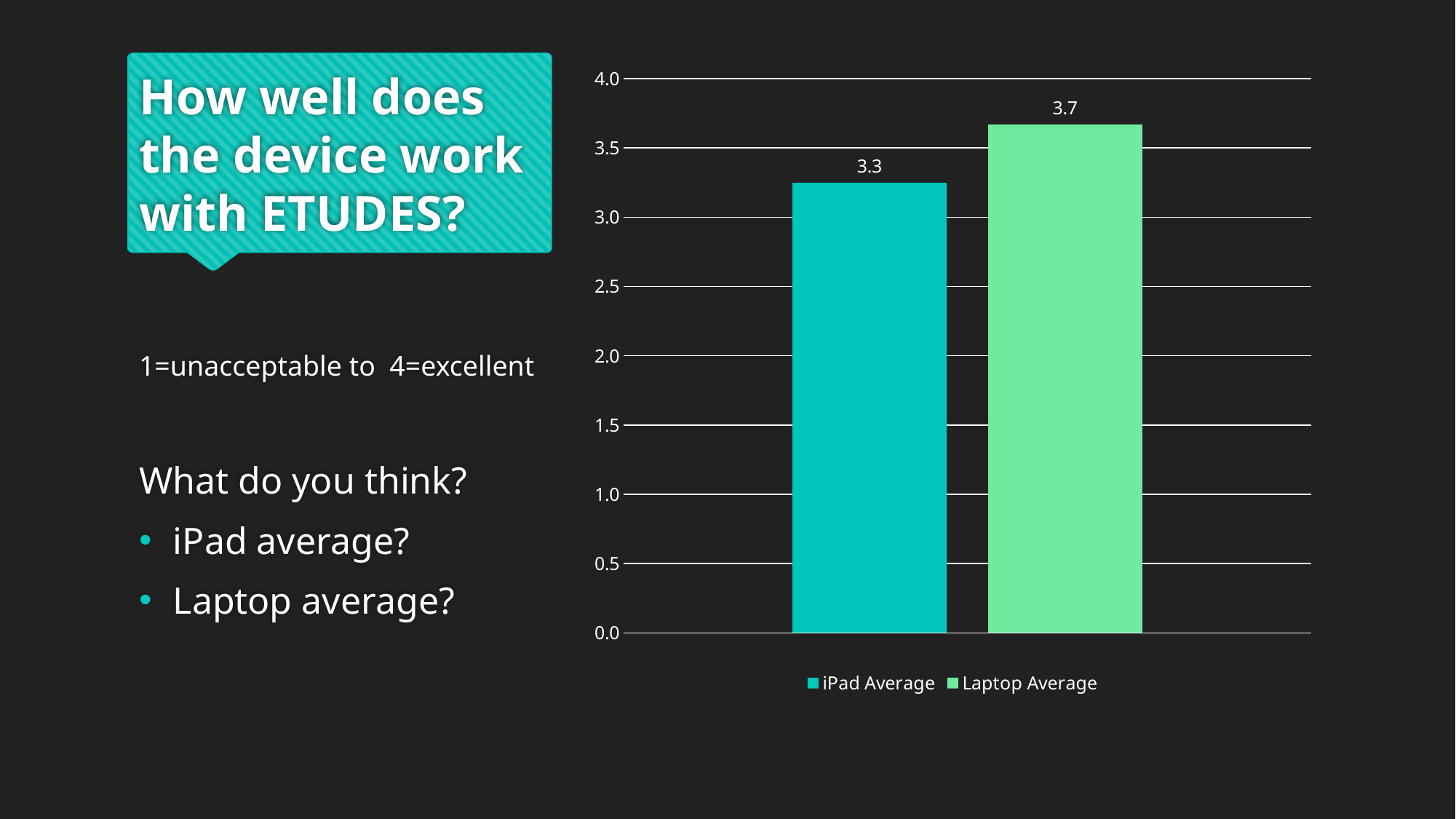
Which series has the higher value, iPad Average or Laptop Average? Laptop Average What is the value of the iPad Average bar? 3.3 How many bars are plotted in the chart? 2 Which series has the lower value? iPad Average What is the difference between the Laptop Average and the iPad Average? 0.4 What colour is the iPad Average bar? teal What kind of chart is shown on the slide? bar chart What is the maximum value shown on the vertical axis? 4.0 Is the Laptop Average greater or less than 3.5? greater What is the value of the Laptop Average bar? 3.7 Is the iPad Average greater or less than 3.5? less How many series does the legend list? 2